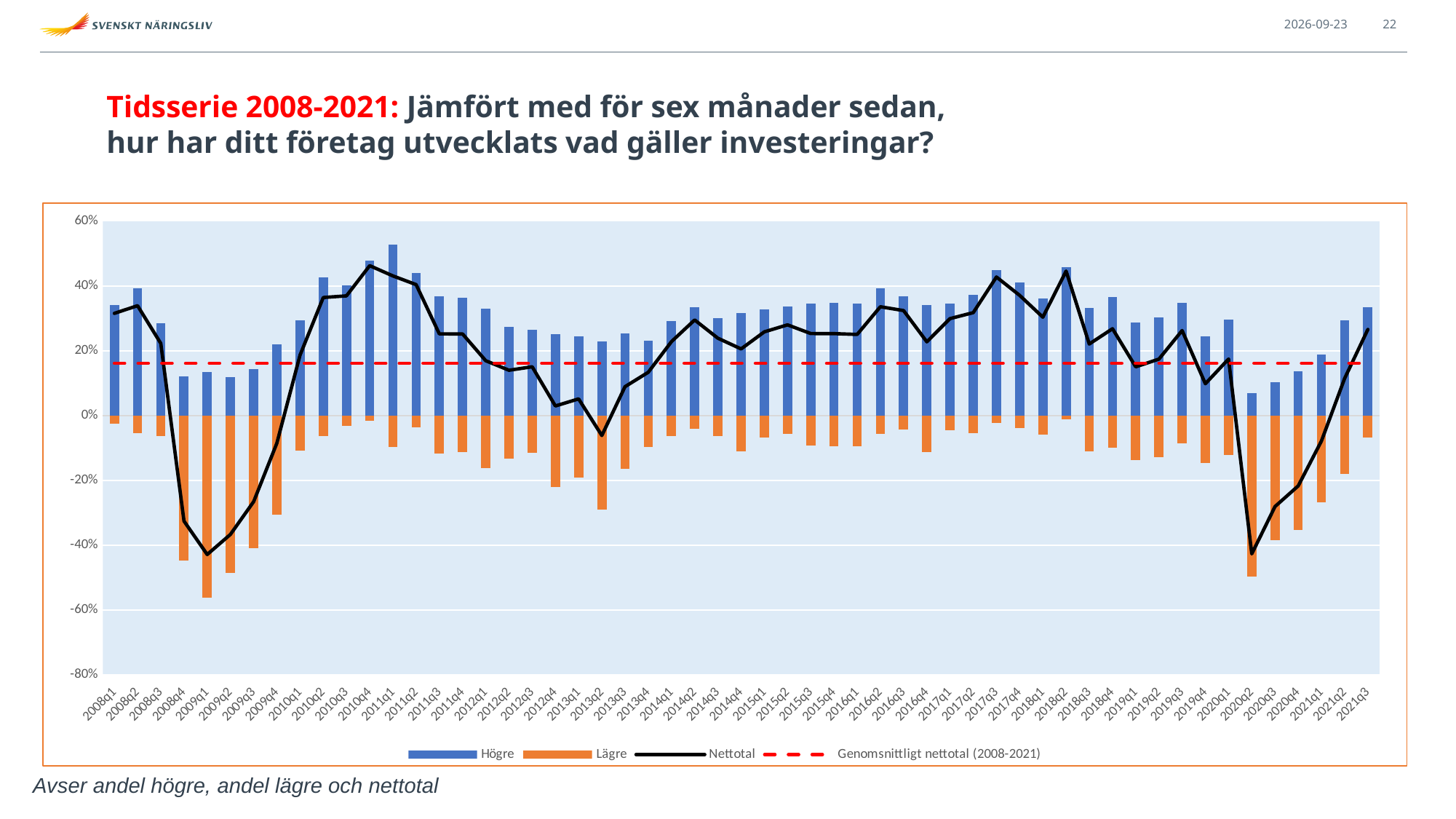
Is the Högre value for 2011q1 greater or less than 40%? greater Which quarter has the most negative value for the Lägre series? 2009q1 Does the Nettotal line rise or fall from 2020q2 to 2021q3? rise Is the Nettotal value for 2020q2 greater or less than -20%? less Which quarter has the lowest value for the Högre series? 2020q2 How many quarters are shown on the x axis? 55 How many series does the legend list? 4 What does the red dashed line represent according to the legend? Genomsnittligt nettotal (2008-2021) Which is larger, the Högre value for 2011q1 or the Högre value for 2020q2? 2011q1 Is the Högre value for 2020q2 greater or less than 20%? less Which quarter has the highest value for the Högre series? 2011q1